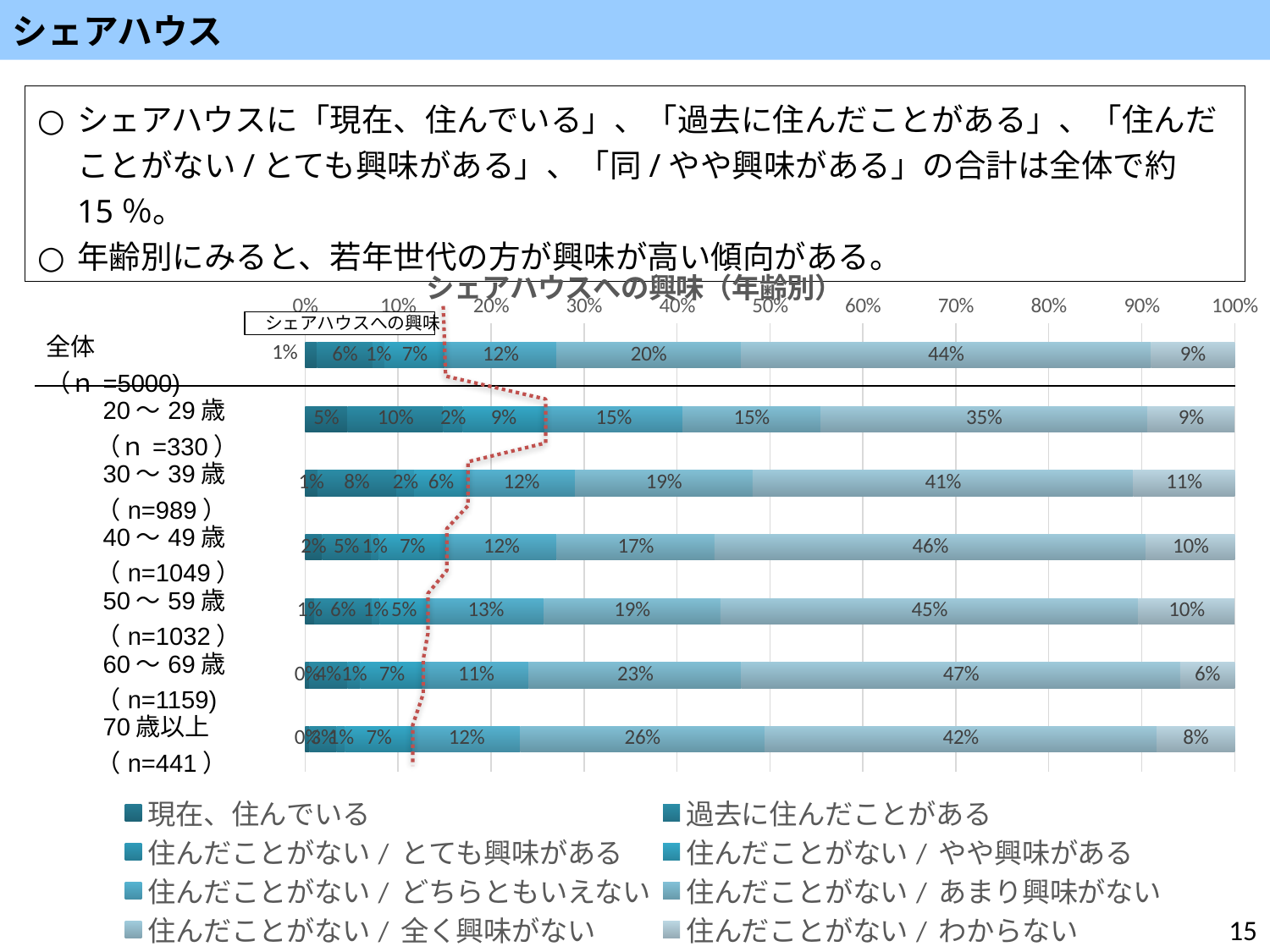
Which is larger: the 「住んだことがない / 全く興味がない」 value for 70歳以上 or for 60～69歳? 60～69歳 What is the value of 「住んだことがない / どちらともいえない」 for 20～29歳? 15% How many series does the legend list? 8 What is the value of 「住んだことがない / あまり興味がない」 for 全体? 20% What is the difference between the 「住んだことがない / あまり興味がない」 values for 60～69歳 and 20～29歳? 8% What is the title of the chart? シェアハウスへの興味（年齢別） How many age categories (including 全体) are plotted on the chart? 7 What is the value of 「過去に住んだことがある」 for 20～29歳? 10% Which age category has the highest value for 「住んだことがない / あまり興味がない」? 70歳以上 What is the value of 「住んだことがない / 全く興味がない」 for 70歳以上? 42% Which age category has the lowest value for 「住んだことがない / あまり興味がない」? 20～29歳 What kind of chart is shown on the slide? stacked bar chart